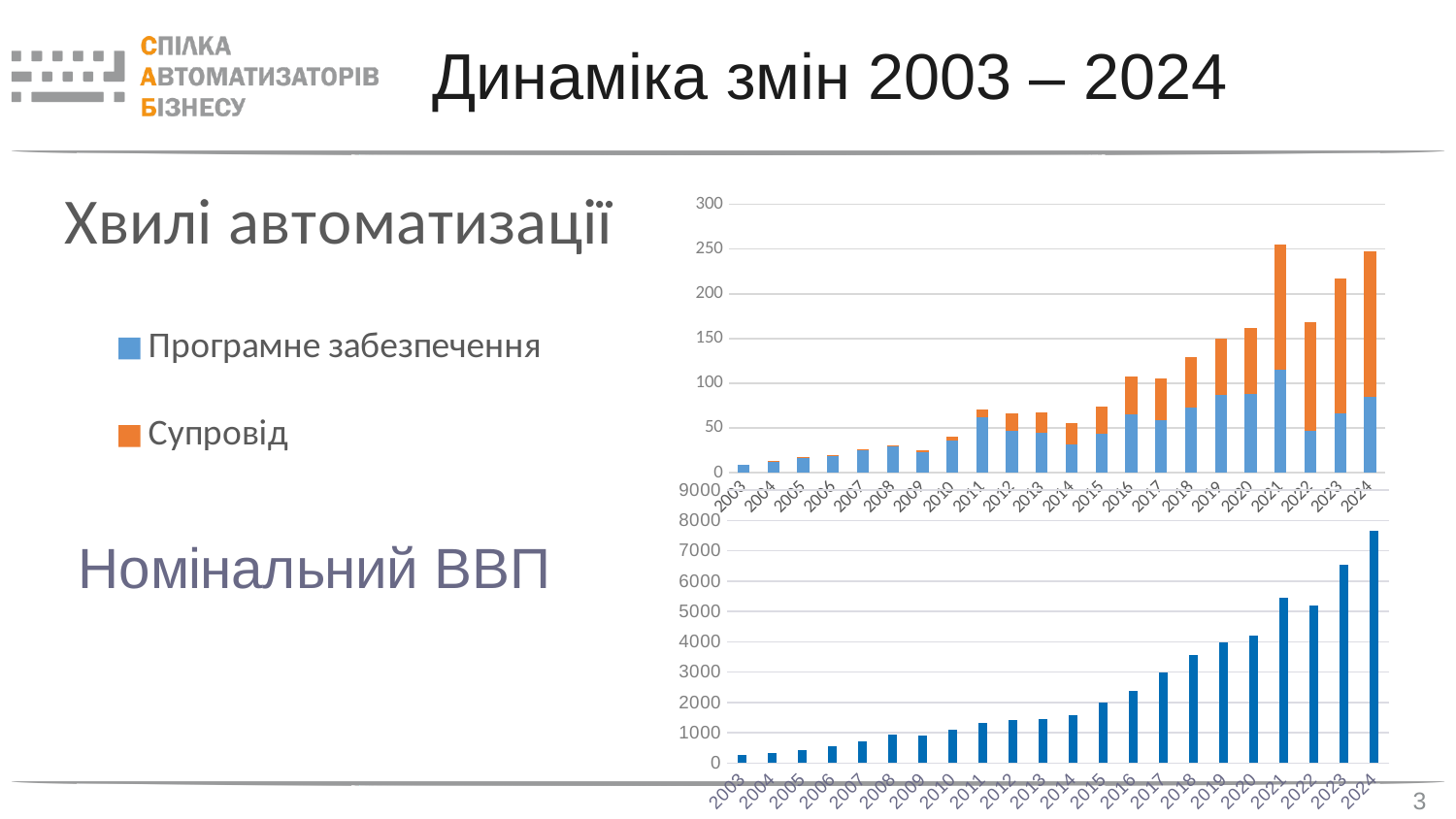
In the top chart "Хвилі автоматизації", is the total bar for 2021 greater or less than 200? greater How many series does the legend of the top chart "Хвилі автоматизації" list? 2 What are the two series named in the legend of the top chart "Хвилі автоматизації"? Програмне забезпечення and Супровід How many years are shown on the x axis of the bottom chart "Номінальний ВВП"? 22 In the bottom chart "Номінальний ВВП", which year has the lowest value? 2003 In the top chart "Хвилі автоматизації", which colour represents Супровід? Orange In the top chart "Хвилі автоматизації", which year has the lowest total bar? 2003 In the bottom chart "Номінальний ВВП", which year has the highest value? 2024 In the bottom chart "Номінальний ВВП", is the value for 2024 greater or less than 7000? greater What kind of chart is the top chart, "Хвилі автоматизації"? Stacked bar chart What kind of chart is the bottom chart, "Номінальний ВВП"? Bar chart In the bottom chart "Номінальний ВВП", is the value for 2018 greater or less than 3000? greater